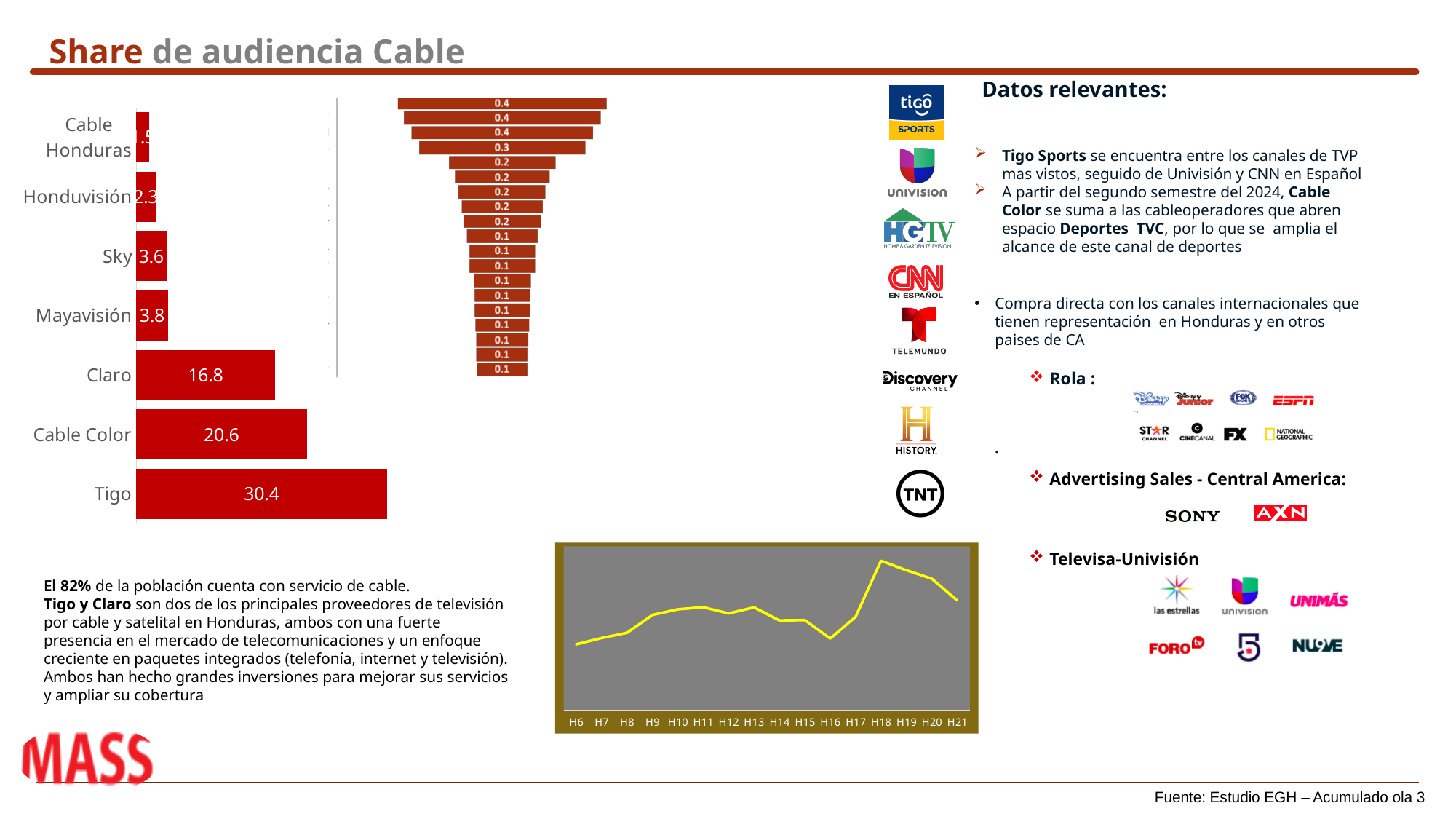
How many categories does the left bar chart show? 7 On the left bar chart, what is the difference between the values for Tigo and Cable Color? 9.8 On the left bar chart, which category has the highest value? Tigo On the left bar chart, what is the value for Sky? 3.6 On the left bar chart, which is larger, the value for Claro or the value for Cable Color? Cable Color On the left bar chart, what is the value for Claro? 16.8 What kind of chart is the chart at the bottom centre of the slide with the H6 to H21 axis? Line chart On the left bar chart, what is the value for Tigo? 30.4 On the left bar chart, what is the value for Cable Color? 20.6 On the bottom centre line chart, at which x-axis label does the line reach its highest point? H18 On the middle bar chart with the 0.4 to 0.1 labels, what is the highest value shown? 0.4 On the left bar chart, what is the difference between the values for Mayavisión and Honduvisión? 1.5